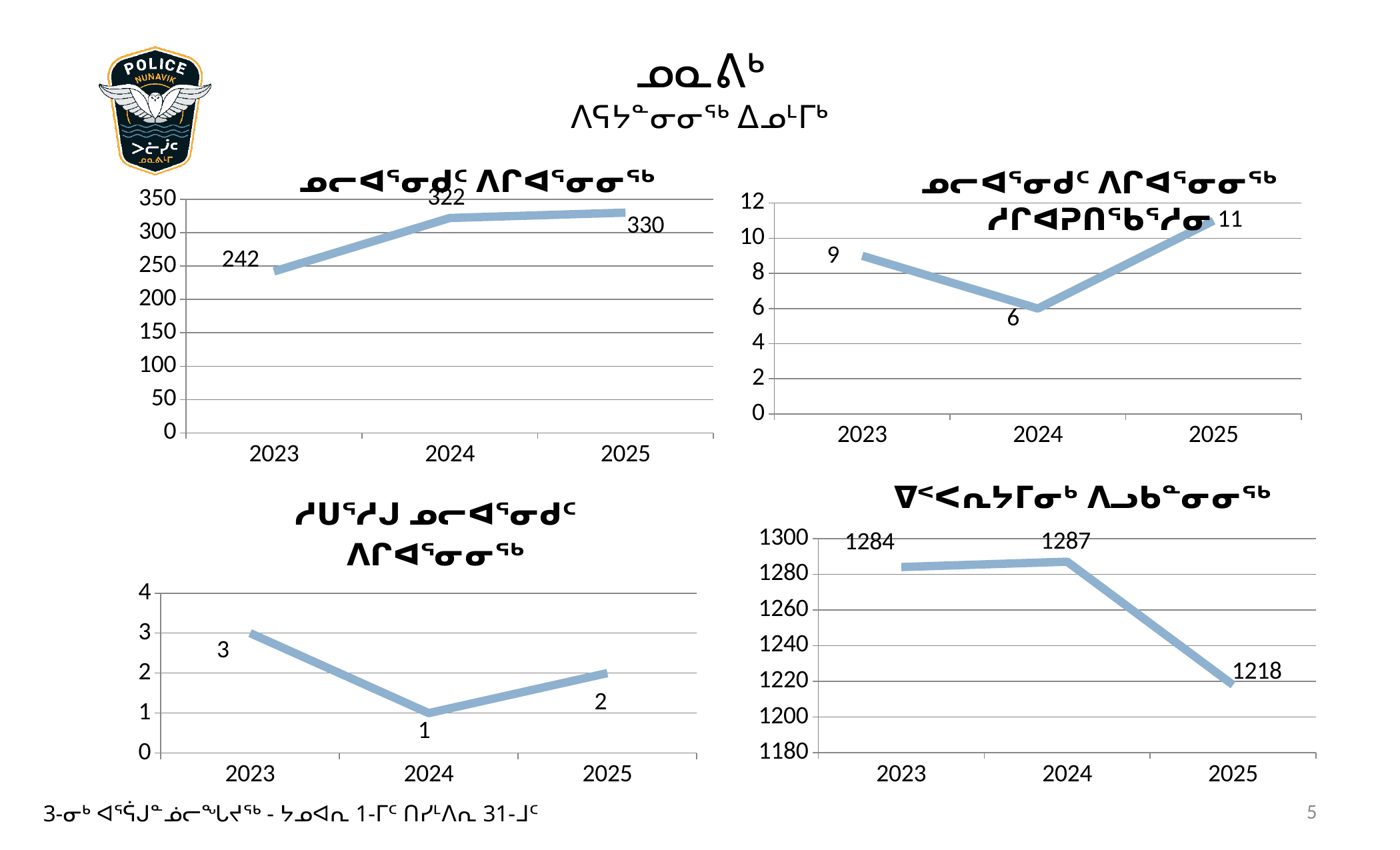
In the top-left chart, what is the difference between the 2024 and 2023 values? 80 In the bottom-left chart, what is the value for 2025? 2 In the top-right chart, is the value for 2025 larger than the value for 2023? Yes In the top-right chart, which year has the lowest value? 2024 In the top-left chart, what is the value for 2023? 242 What type of chart is the top-left chart? Line chart In the bottom-right chart, what is the value for 2024? 1287 In the top-left chart, which year has the highest value? 2025 In the bottom-right chart, what is the difference between the 2024 and 2025 values? 69 In the bottom-left chart, how many data points are plotted? 3 In the top-right chart, what is the value for 2024? 6 In the bottom-right chart, do the values rise or fall from 2024 to 2025? Fall